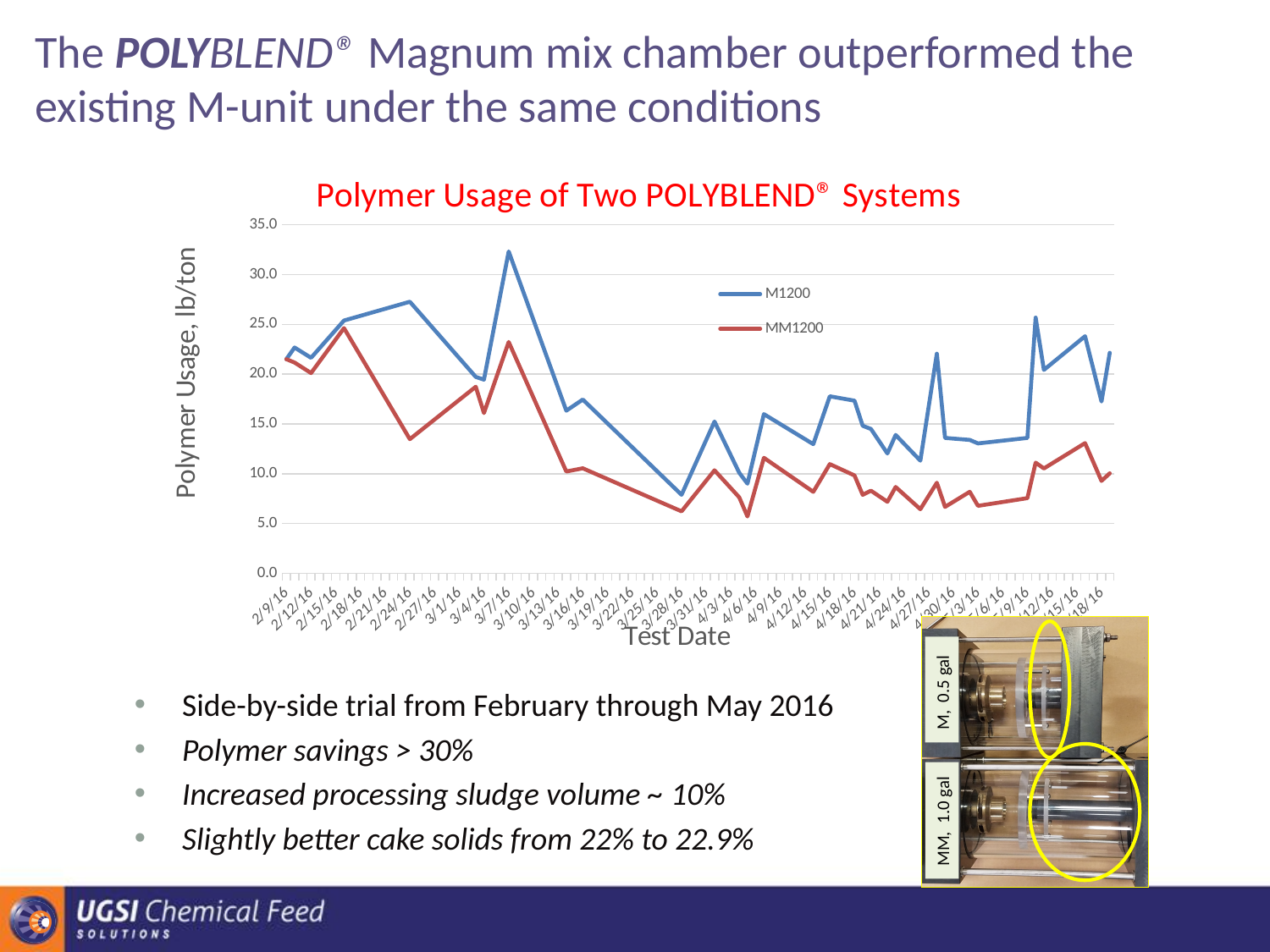
Which series is lower for most of the test dates shown? MM1200 What are the two series named in the chart legend? M1200 and MM1200 What kind of chart is shown on the slide? line chart Does the M1200 series rise or fall between 3/7/16 and 3/28/16? fall What is the label of the vertical axis of the chart? Polymer Usage, lb/ton How many series does the chart legend list? 2 Is the peak value of the M1200 series greater or less than 30.0? greater Is the value of the MM1200 series on 3/28/16 greater or less than 10.0? less Is the value of the MM1200 series on 2/24/16 greater or less than 15.0? less Which series has the higher value on 3/7/16, M1200 or MM1200? M1200 Which series reaches the highest value anywhere on the chart? M1200